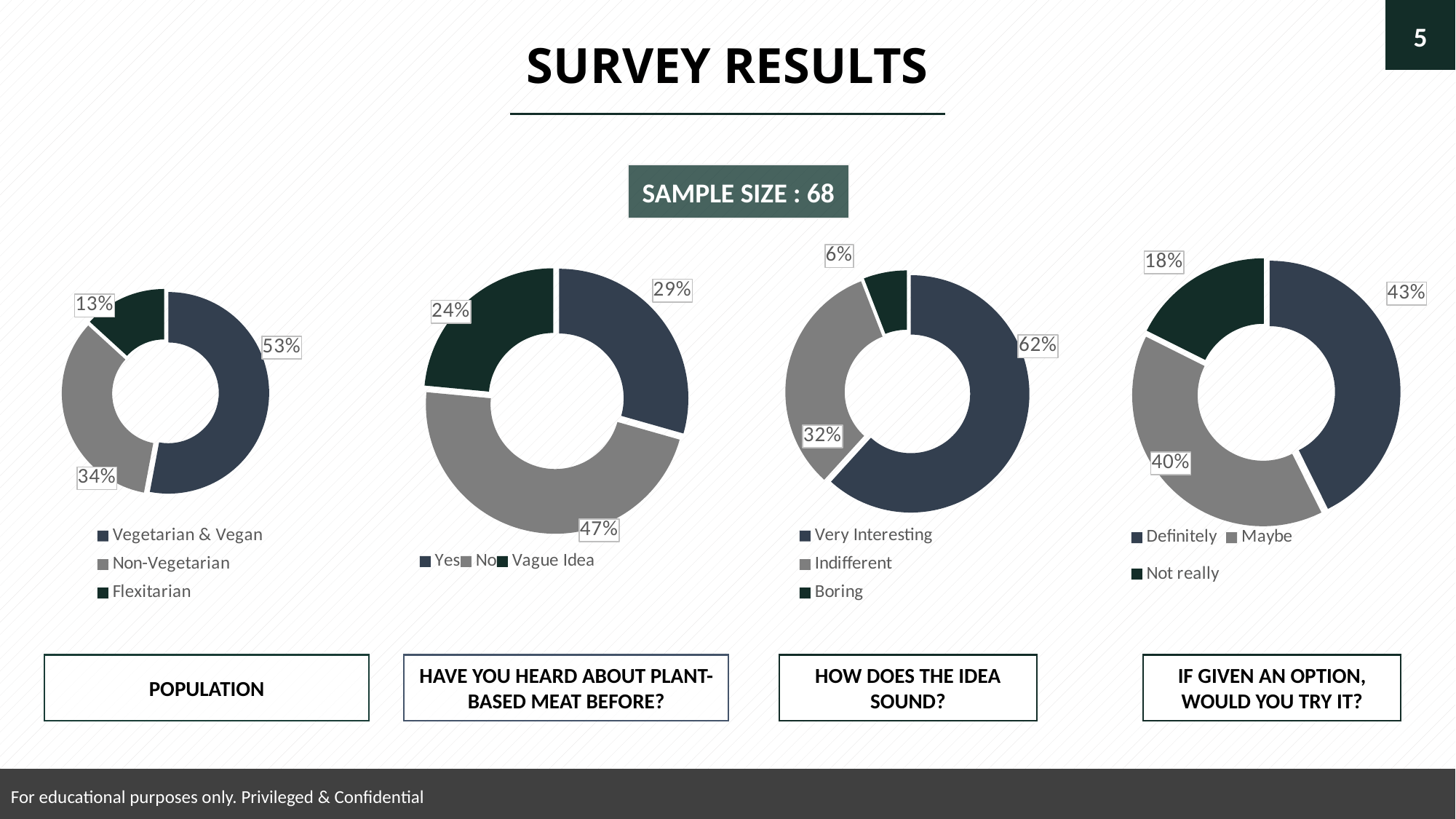
In the 'If given an option, would you try it?' chart, what share answered Not really? 18% In the 'How does the idea sound?' chart, which response has the largest share? Very Interesting In the Population chart, which is larger, Non-Vegetarian or Flexitarian? Non-Vegetarian What kind of chart is the Population chart? doughnut chart In the 'Have you heard about plant-based meat before?' chart, which response has the smallest share? Vague Idea In the 'How does the idea sound?' chart, what share answered Very Interesting? 62% How many categories does the 'How does the idea sound?' chart have? 3 In the Population chart, what share is Flexitarian? 13% In the 'If given an option, would you try it?' chart, what is the difference between Definitely and Maybe? 3% What sample size is stated on the slide? 68 In the Population chart, what share is Vegetarian & Vegan? 53% In the 'Have you heard about plant-based meat before?' chart, what share answered No? 47%